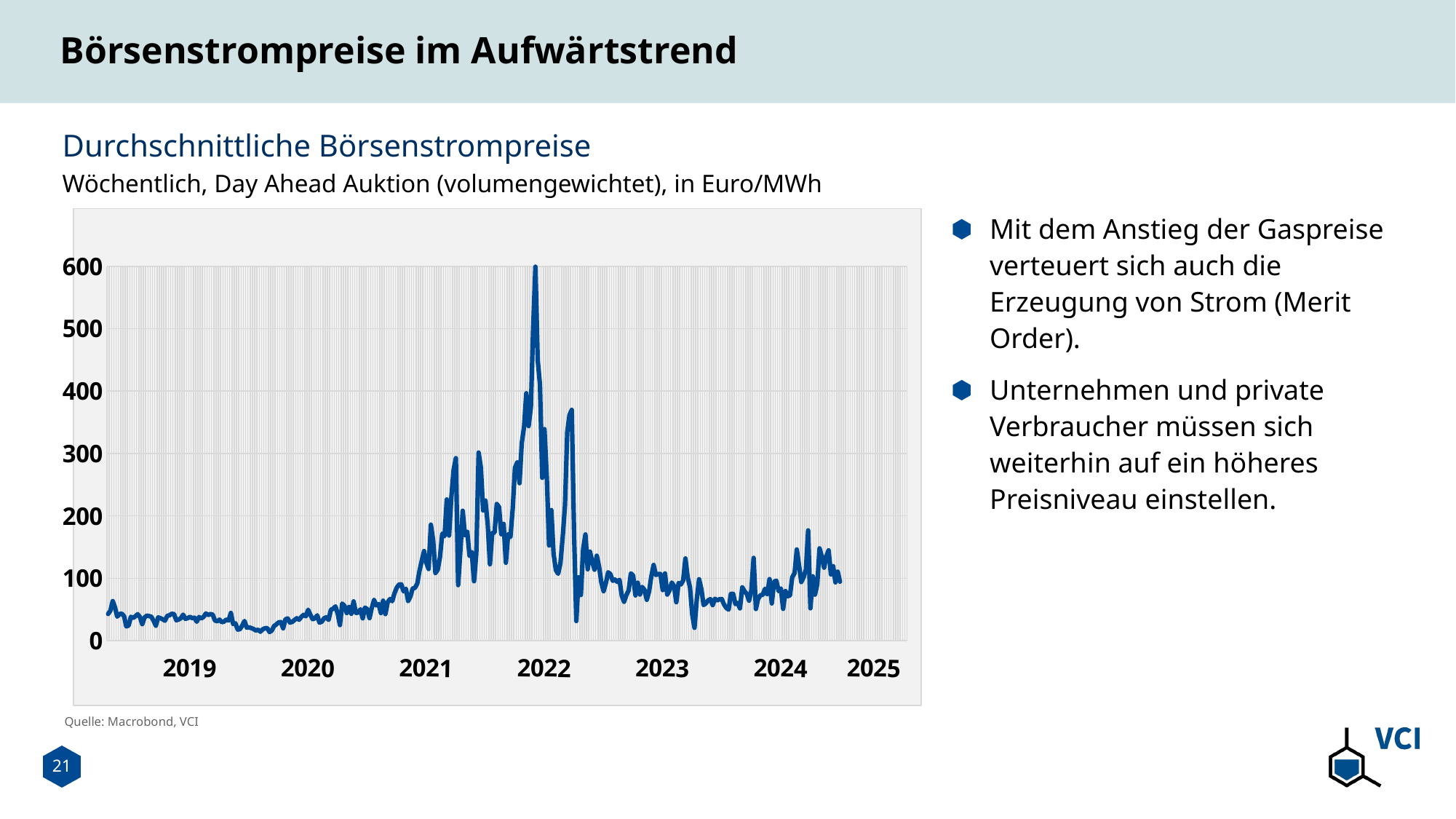
In which year does the line reach its highest point? 2022 Do the values rise or fall from 2019 to the end of 2021? rise How many lines are plotted in the chart? 1 Are the values during 2023 greater or less than 200? less Is the value at the end of the series in 2024 greater or less than 200? less In what unit are the prices in the chart given? Euro/MWh Are the values at the start of the series in 2019 greater or less than 100? less What kind of chart is shown on the slide? line chart What is the title of the chart? Durchschnittliche Börsenstrompreise What is the highest value shown on the y axis? 600 Do the values rise or fall from the 2022 peak to 2023? fall